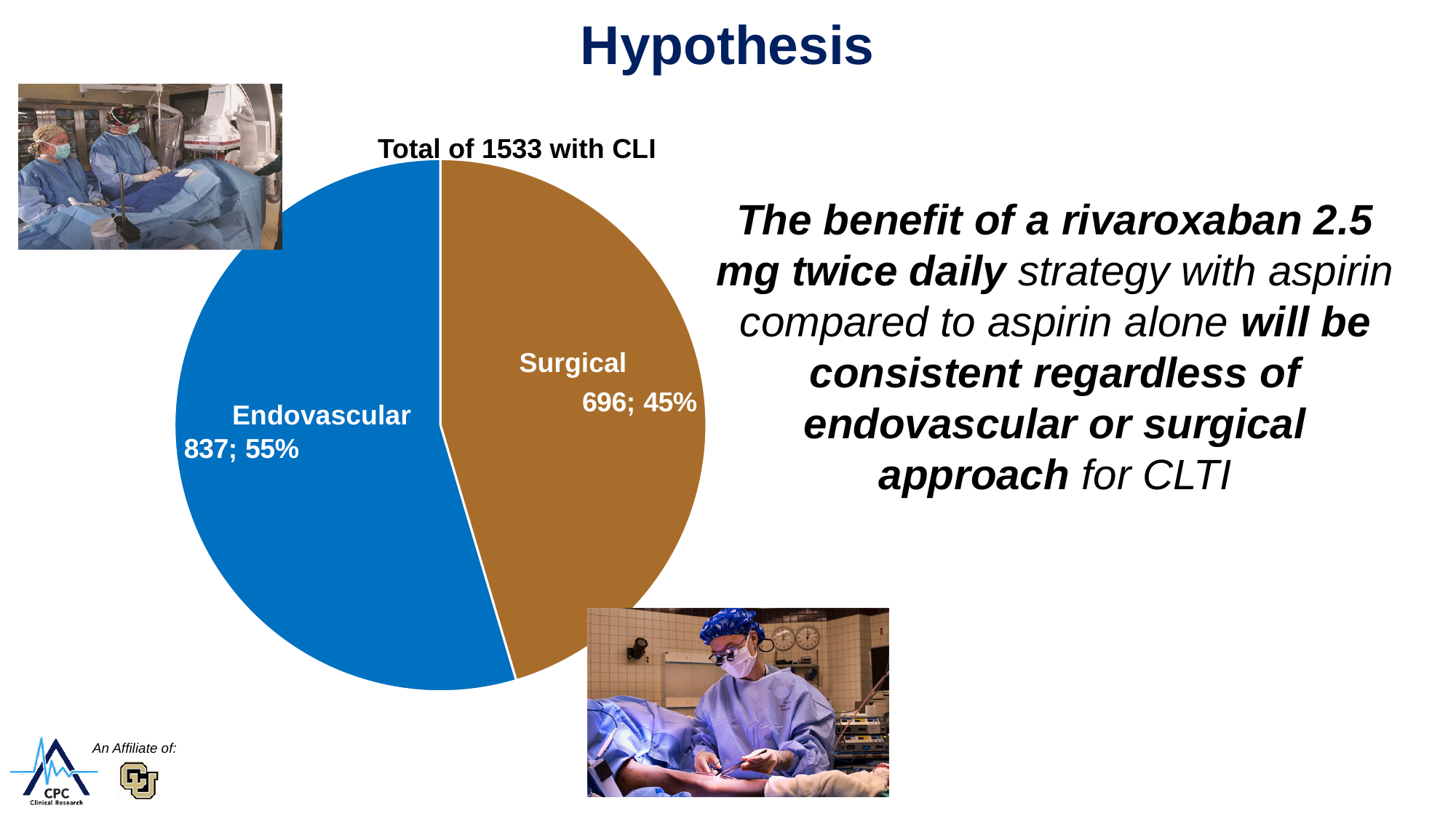
What is the count for the Endovascular slice? 837 What is the count for the Surgical slice? 696 What share of the pie does the Surgical slice represent? 45% How many slices does the pie chart have? 2 What is the title of the pie chart? Total of 1533 with CLI What colour is the Surgical slice? brown What kind of chart is shown on the slide? pie chart Which slice is the largest? Endovascular Which slice is the smallest? Surgical Which is larger, the Endovascular count or the Surgical count? Endovascular What is the difference in count between the Endovascular and Surgical slices? 141 What share of the pie does the Endovascular slice represent? 55%